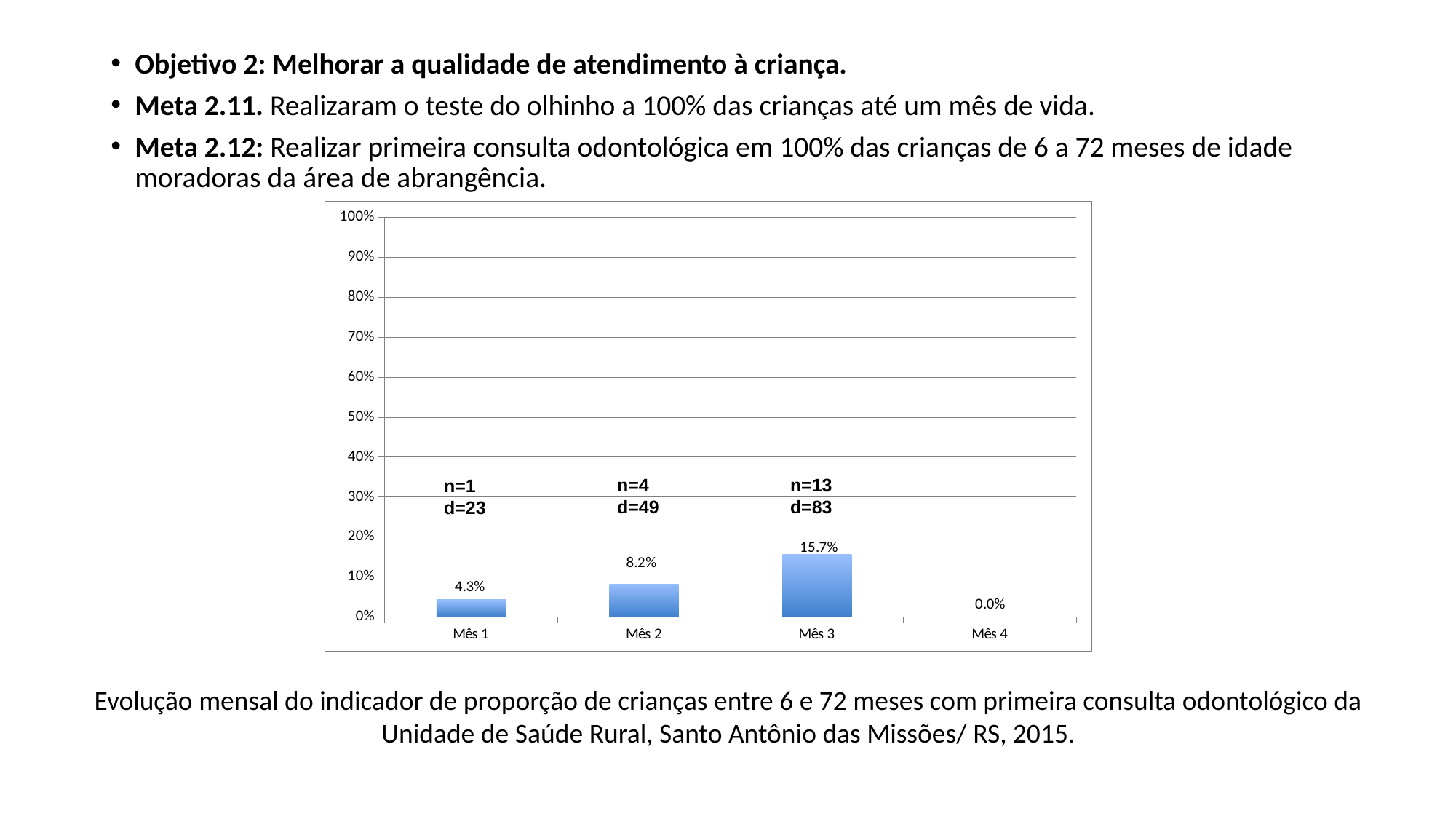
What is the value for Mês 3? 15.7% Which month has the highest value? Mês 3 What is the value for Mês 2? 8.2% What is the denominator (d) shown above the bar for Mês 3? 83 What is the difference between the values for Mês 3 and Mês 2? 7.5% What is the value for Mês 4? 0.0% What kind of chart is shown on the slide? bar chart Which month has the lowest value? Mês 4 Is the value for Mês 3 greater or less than 20%? less What is the value for Mês 1? 4.3% Which is larger, the value for Mês 1 or the value for Mês 2? Mês 2 How many months are shown on the x axis? 4